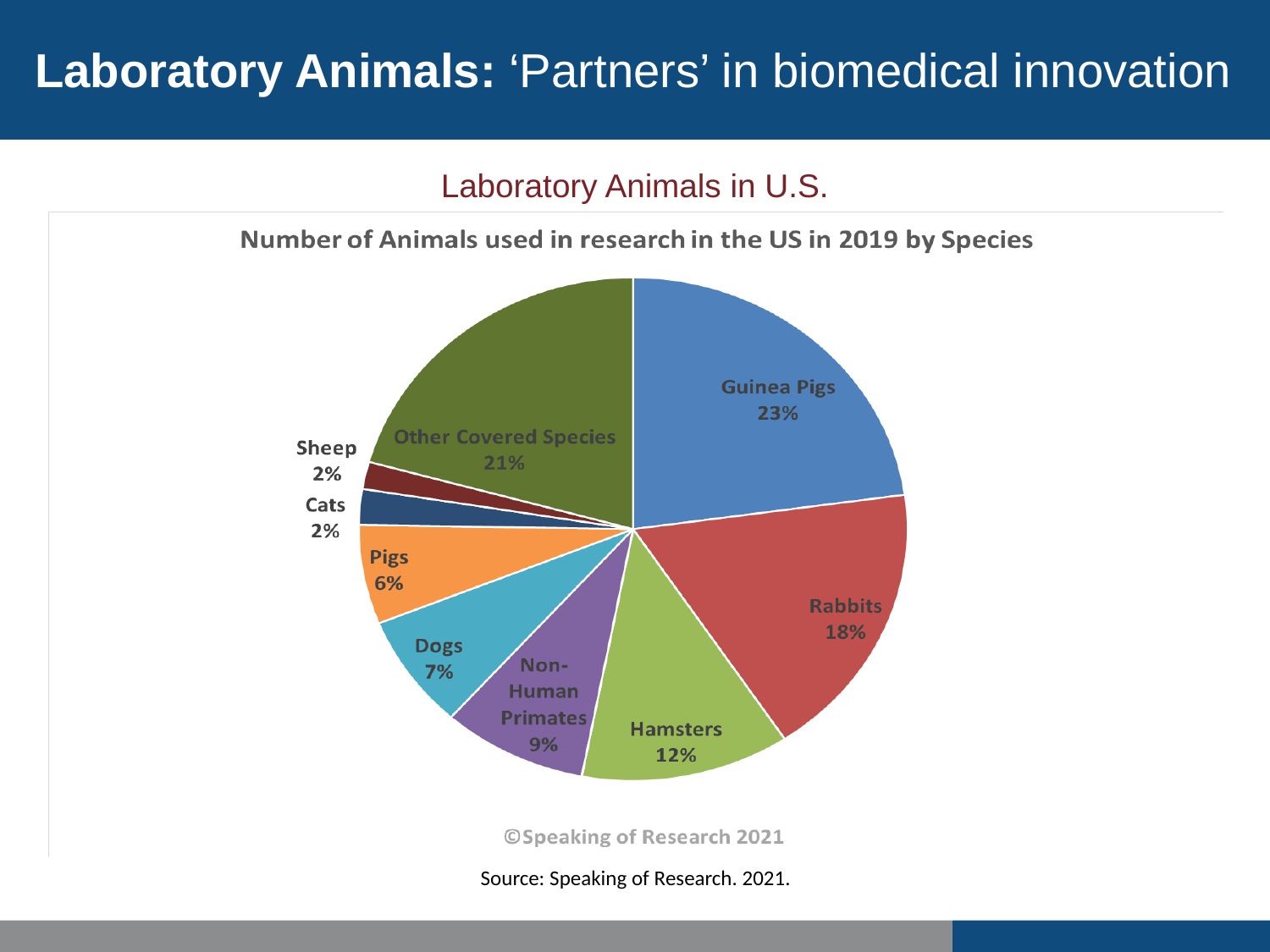
What type of chart is shown on the slide? pie chart What is the combined percentage of Guinea Pigs and Rabbits? 41% How many slices does the pie chart have? 9 Which is larger, the share for Pigs or the share for Dogs? Dogs What share of the pie is Rabbits? 18% Which species has the largest share of the pie? Guinea Pigs What percentage of animals used in research in the US in 2019 were Guinea Pigs? 23% What is the title of the chart? Number of Animals used in research in the US in 2019 by Species Which species share the smallest slice of the pie? Sheep and Cats What is the difference in percentage points between Hamsters and Dogs? 5 What percentage is shown for Non-Human Primates? 9% What percentage is shown for Other Covered Species? 21%